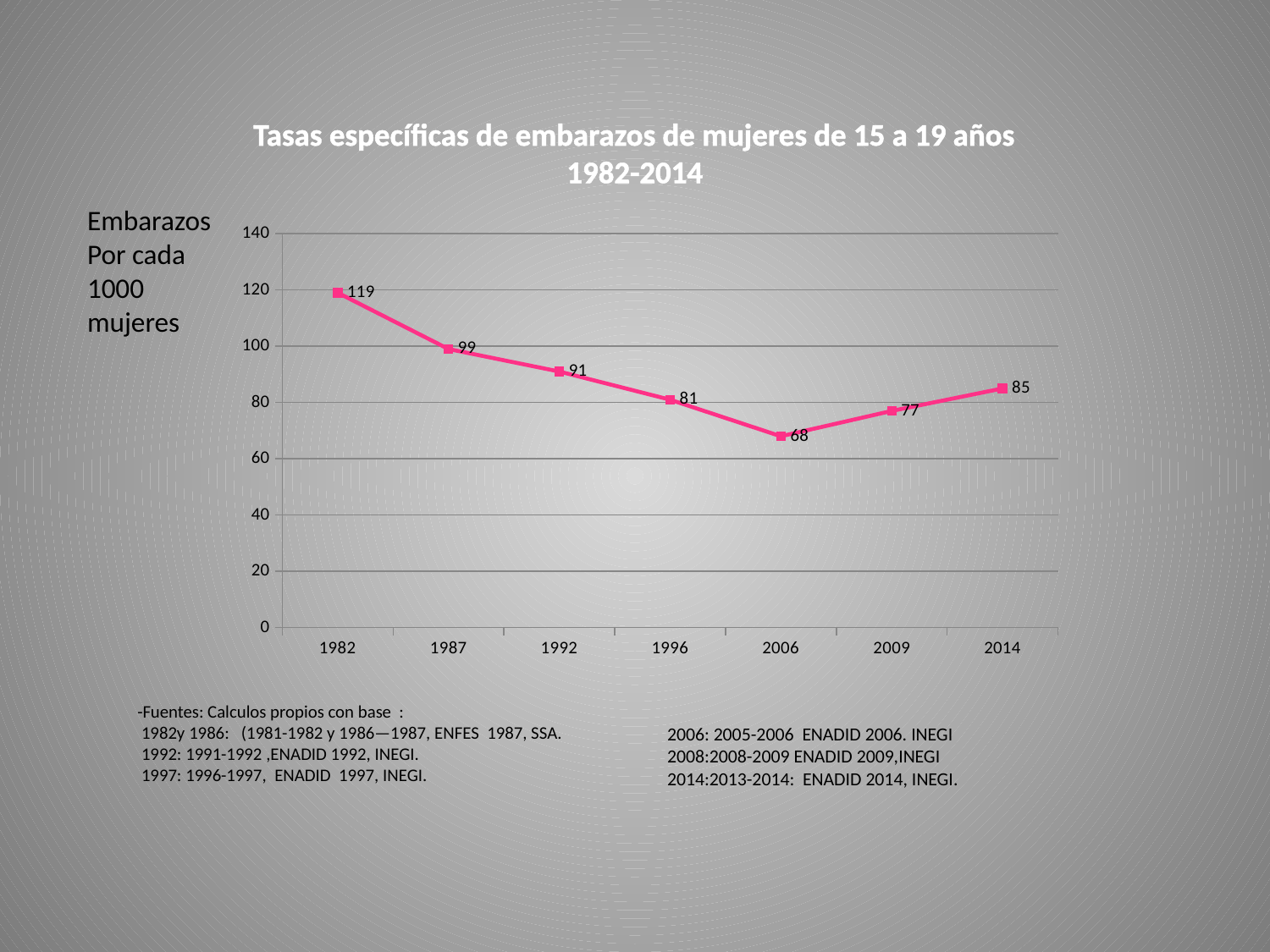
What is the title of the chart? Tasas específicas de embarazos de mujeres de 15 a 19 años 1982-2014 Is the value for 1987 greater or less than 100? less Which is larger, the value for 2009 or the value for 1996? 1996 What is the value for 1982? 119 Which year has the lowest value? 2006 Which year has the highest value? 1982 What is the value for 2014? 85 How many years are plotted on the x axis? 7 What kind of chart is shown? line chart What is the value for 2006? 68 Do the values rise or fall from 1982 to 2006? fall What is the difference between the values for 1982 and 2014? 34